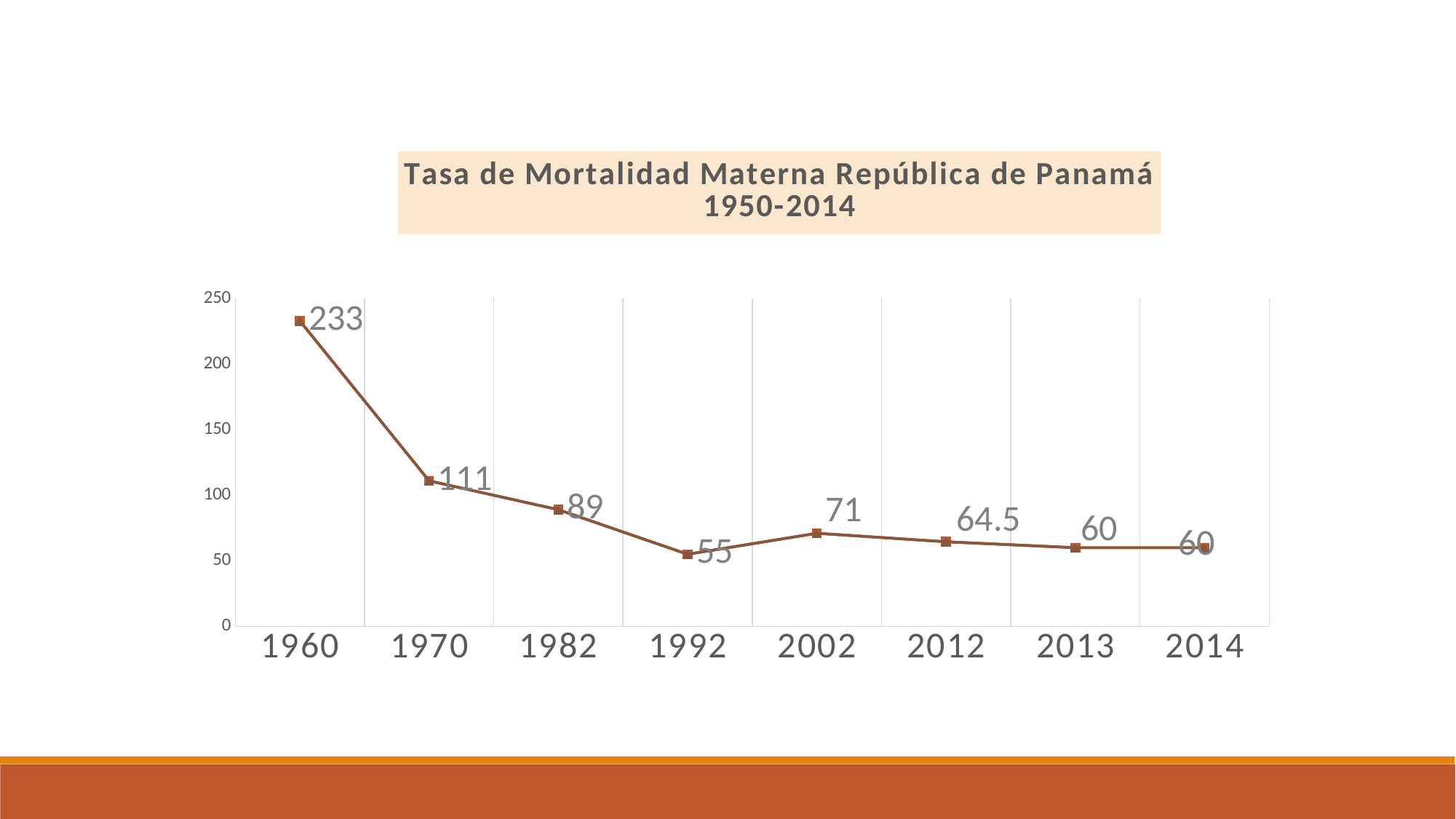
What is the difference between the values for 1960 and 1970? 122 Is the value for 1970 greater or less than 100? greater Which year has the highest value? 1960 What is the value for 1960? 233 What is the value for 1992? 55 What is the title of the chart? Tasa de Mortalidad Materna República de Panamá 1950-2014 How many years are plotted on the x axis? 8 Which is larger, the value for 1982 or the value for 2002? 1982 What is the value for 2012? 64.5 Which year has the lowest value? 1992 What kind of chart is shown? line chart What is the difference between the values for 2002 and 1992? 16